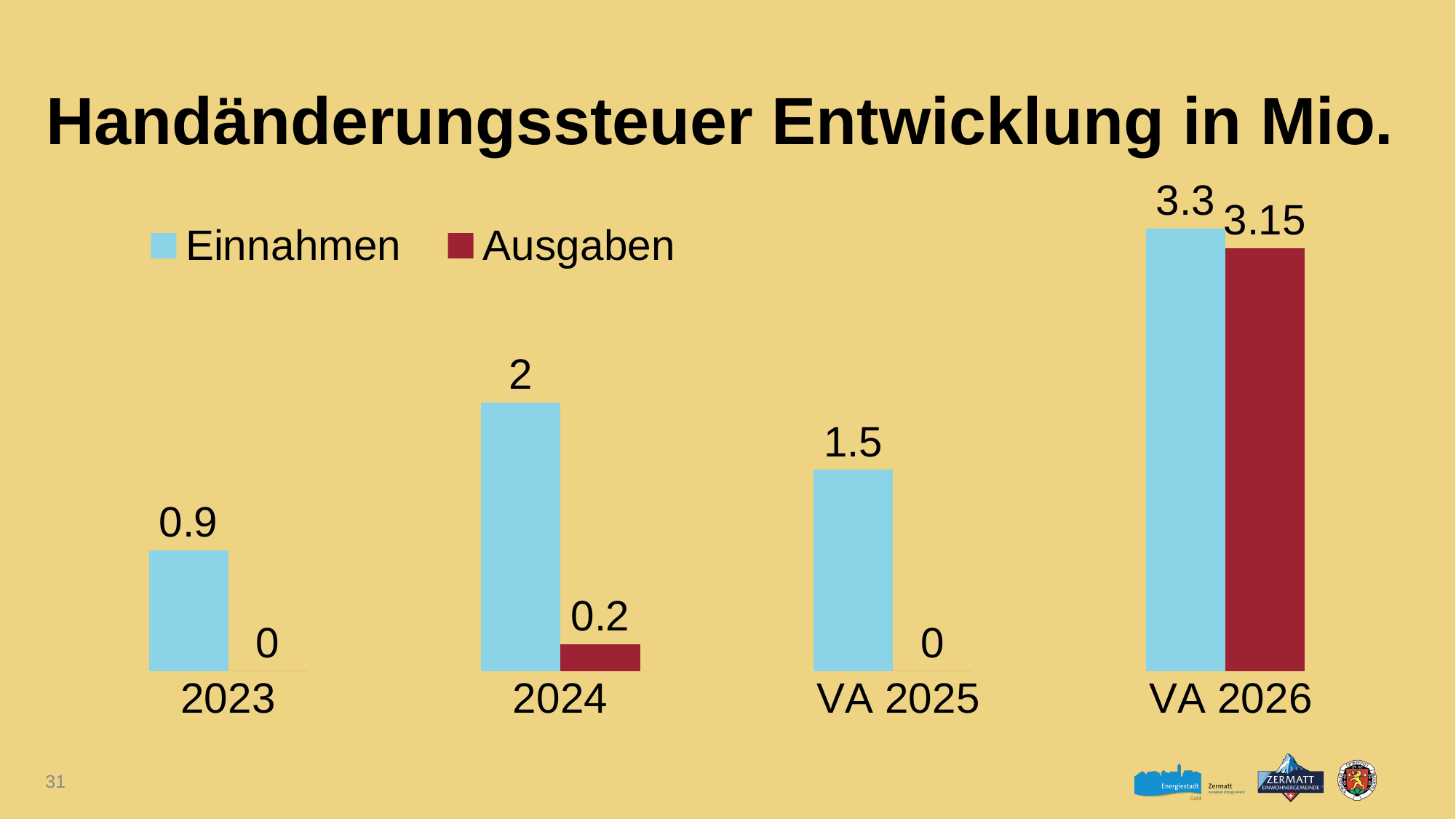
Which category has the highest Einnahmen value? VA 2026 What kind of chart is shown on the slide? Bar chart What is the Einnahmen value for 2023? 0.9 What is the Ausgaben value for VA 2025? 0 How many series does the legend list? 2 What is the Einnahmen value for 2024? 2 Which category has the lowest Einnahmen value? 2023 What is the Ausgaben value for VA 2026? 3.15 Which is larger, the Einnahmen value for 2024 or the Einnahmen value for VA 2025? 2024 How many categories are shown on the x axis? 4 What is the difference between the Einnahmen values for 2024 and VA 2025? 0.5 What is the difference between Einnahmen and Ausgaben for VA 2026? 0.15